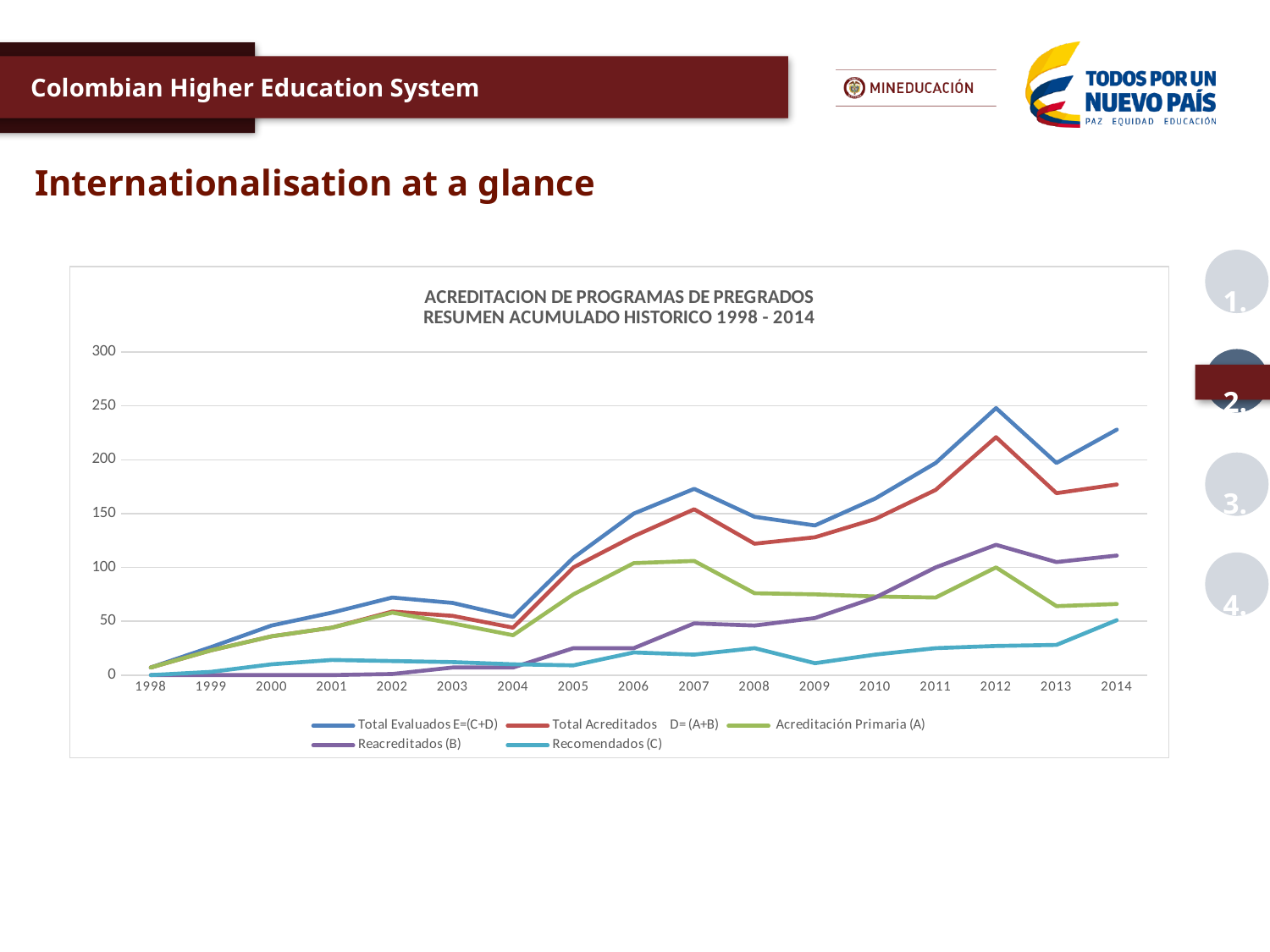
What is the title of the chart? ACREDITACION DE PROGRAMAS DE PREGRADOS RESUMEN ACUMULADO HISTORICO 1998 - 2014 In which year does the Total Evaluados E=(C+D) series reach its highest value? 2012 How many years are plotted along the x axis of the chart? 17 Is the value for Reacreditados (B) in 2012 greater or less than 100? greater Does the Total Evaluados E=(C+D) series rise or fall from 2012 to 2013? fall Is the value for Total Acreditados D=(A+B) in 2008 greater or less than 150? less In which year is the Total Evaluados E=(C+D) series at its lowest value? 1998 How many series does the chart legend list? 5 Is the value for Total Evaluados E=(C+D) in 2012 greater or less than 200? greater What kind of chart is shown on the slide? line chart In 2014, which series has the larger value: Reacreditados (B) or Acreditación Primaria (A)? Reacreditados (B)